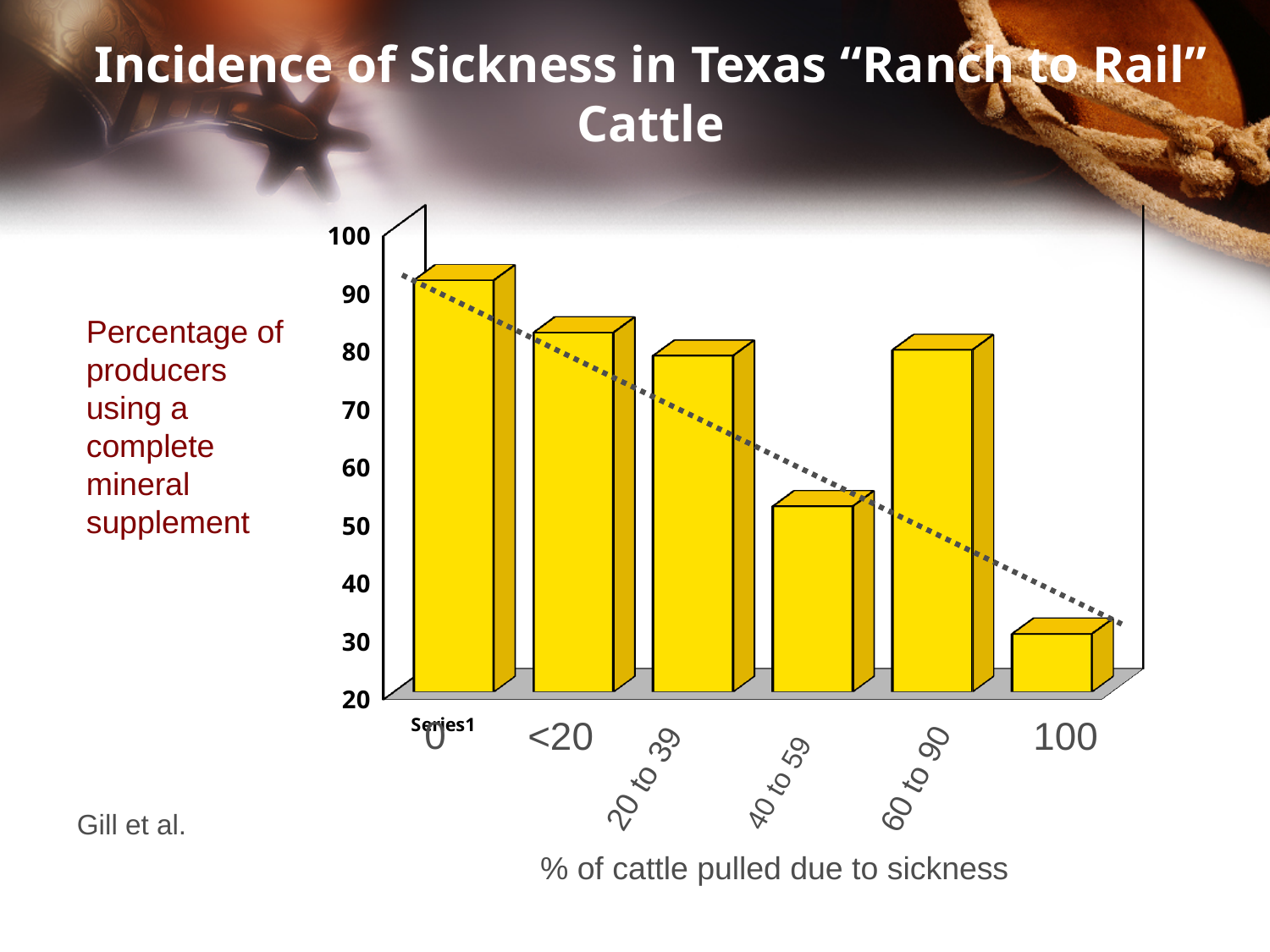
How many categories are plotted along the x axis? 6 Which category has the lowest bar? 100 Is the value for the "60 to 90" category greater or less than 70? greater Which is larger, the value for "40 to 59" or the value for "60 to 90"? 60 to 90 Which category has the highest bar? 0 Is the value for the "40 to 59" category greater or less than 60? less Is the value for the "100" category greater or less than 40? less What kind of chart is shown on the slide? bar chart What is the label of the x axis? % of cattle pulled due to sickness Do the bar values generally rise or fall from left to right along the x axis? fall